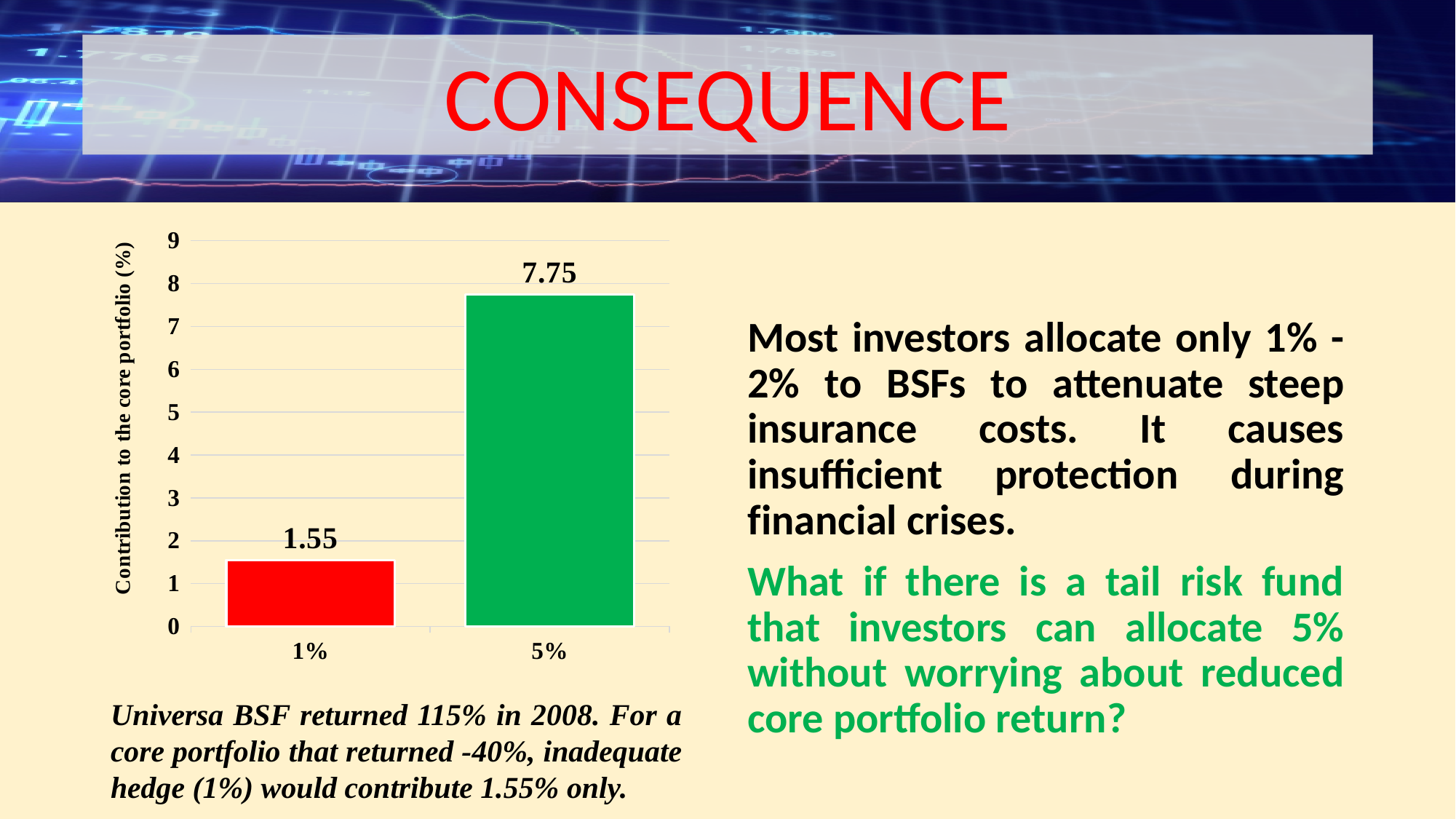
Do the values rise or fall from the 1% category to the 5% category? Rise What kind of chart is shown on the slide? Bar chart What colour is the bar for the 1% allocation? Red Is the contribution for the 1% allocation greater or less than 2? less What is the label of the vertical axis of the chart? Contribution to the core portfolio (%) How many categories are shown on the x axis of the chart? 2 Which allocation has the lower contribution to the core portfolio? 1% What is the difference between the contributions for the 5% and 1% allocations? 6.2 Is the contribution for the 5% allocation greater or less than 7? greater What is the contribution to the core portfolio for the 5% allocation? 7.75 What is the contribution to the core portfolio for the 1% allocation? 1.55 Which allocation has the higher contribution to the core portfolio? 5%